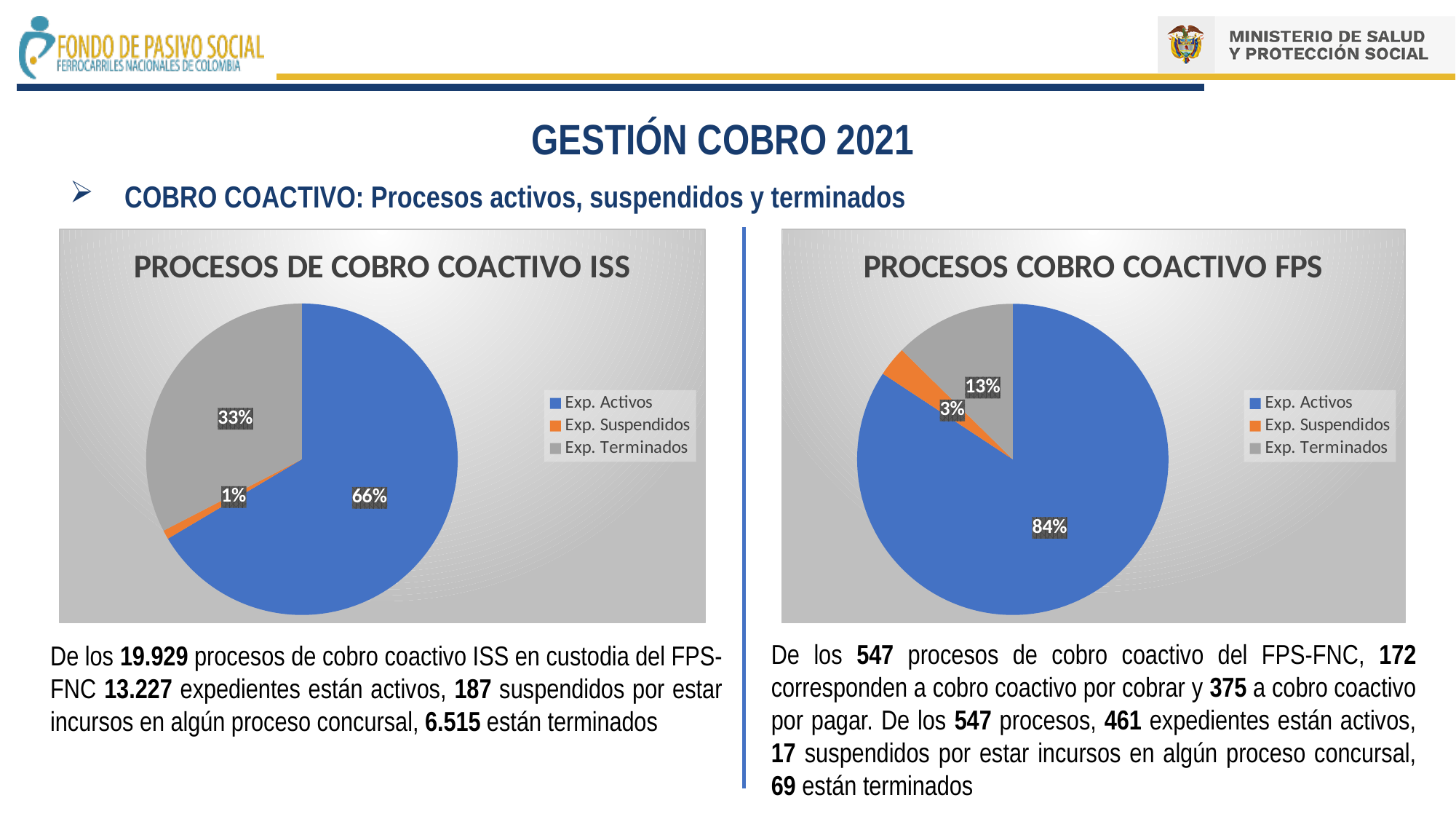
How many entries does the legend of the 'PROCESOS DE COBRO COACTIVO ISS' chart list? 3 In the 'PROCESOS COBRO COACTIVO FPS' chart, what share of the pie is Exp. Terminados? 13% What kind of chart is 'PROCESOS COBRO COACTIVO FPS'? Pie chart In the 'PROCESOS COBRO COACTIVO FPS' chart, what share of the pie is Exp. Suspendidos? 3% In the 'PROCESOS COBRO COACTIVO FPS' chart, which is larger, Exp. Terminados or Exp. Suspendidos? Exp. Terminados In the 'PROCESOS DE COBRO COACTIVO ISS' chart, what is the difference in percentage points between Exp. Activos and Exp. Terminados? 33 In the 'PROCESOS COBRO COACTIVO FPS' chart, what share of the pie is Exp. Activos? 84% In the 'PROCESOS COBRO COACTIVO FPS' chart, which category has the smallest slice? Exp. Suspendidos In the 'PROCESOS DE COBRO COACTIVO ISS' chart, which category has the largest slice? Exp. Activos